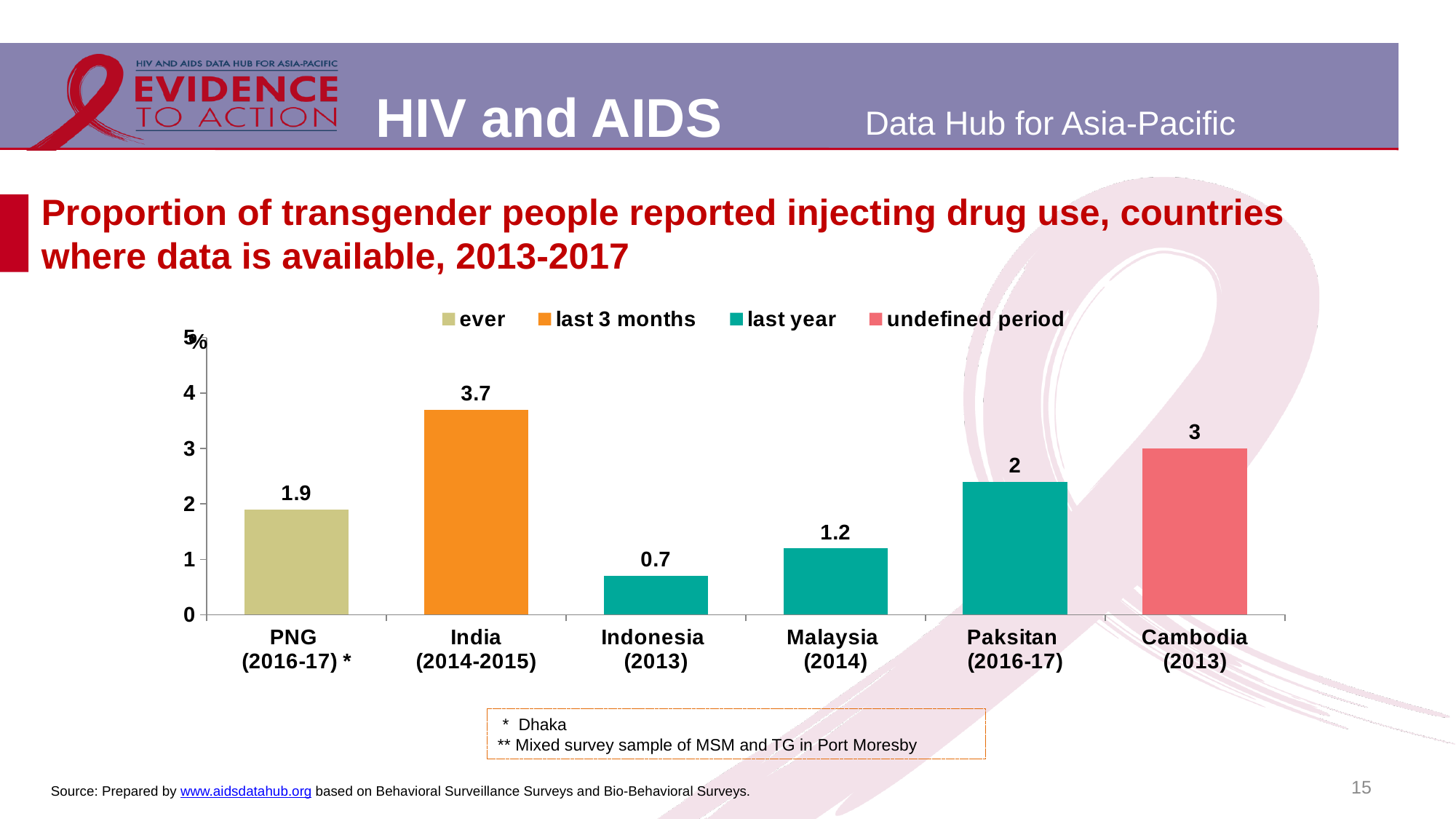
Which is larger, the value for Malaysia (2014) or the value for Paksitan (2016-17)? Paksitan (2016-17) What is the value for Cambodia (2013)? 3 What kind of chart is shown on the slide? bar chart Is the value for Cambodia (2013) greater or less than 2? greater Which legend series do the bars for Indonesia, Malaysia and Paksitan belong to? last year How many countries are shown on the chart? 6 How many series does the legend list? 4 What is the value for Indonesia (2013)? 0.7 What is the difference between the values for India (2014-2015) and PNG (2016-17)? 1.8 What is the value for India (2014-2015)? 3.7 Which country has the highest proportion of transgender people reporting injecting drug use? India (2014-2015) Which country has the lowest proportion of transgender people reporting injecting drug use? Indonesia (2013)